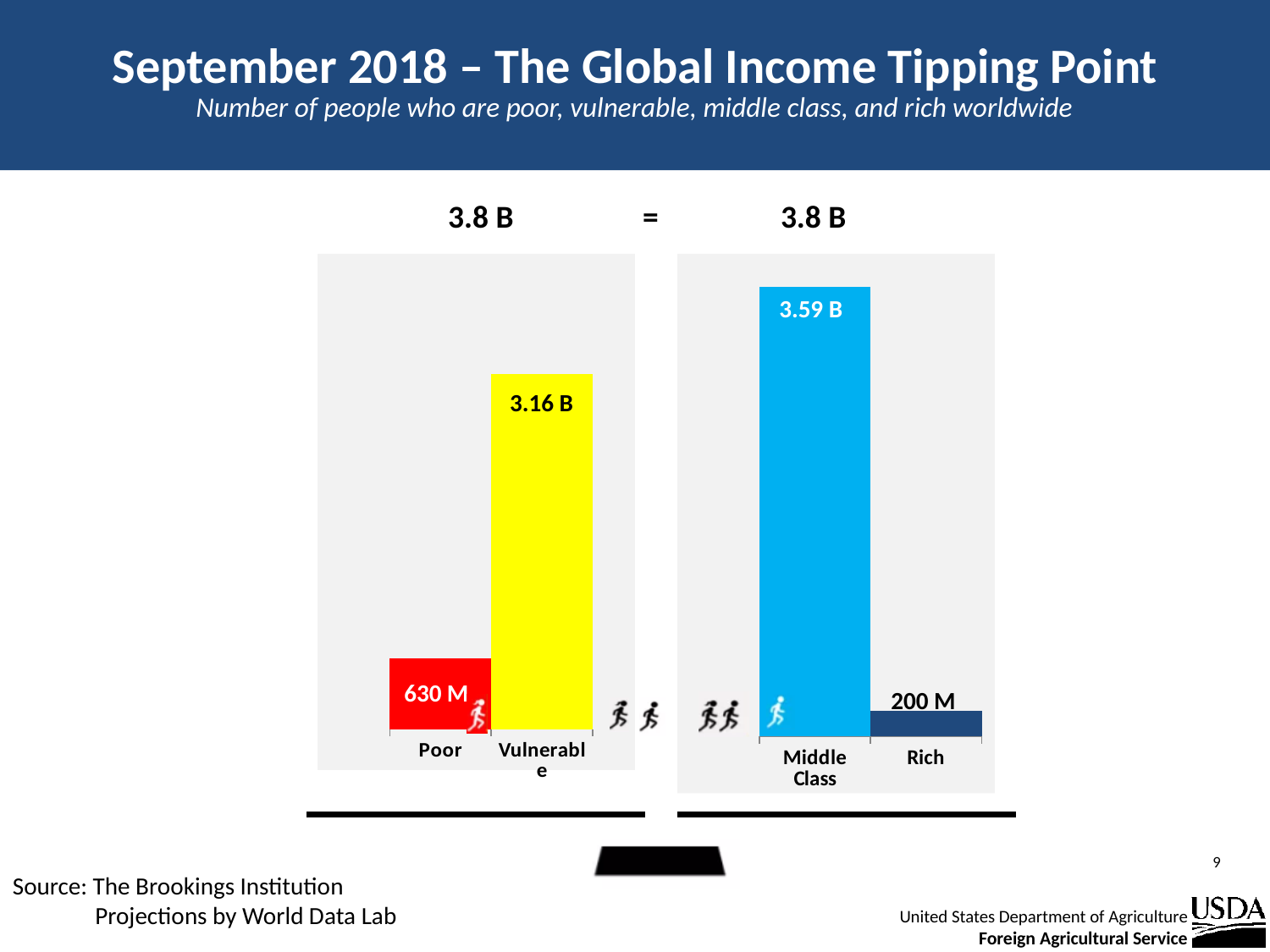
Which category has the lowest value? Rich What is the difference between the value for Poor and the value for Rich? 430 M What is the value for Vulnerable? 3.16 B What total is shown above the Poor and Vulnerable bars? 3.8 B What is the value for Middle Class? 3.59 B What is the value for Rich? 200 M What is the value for Poor? 630 M Which is larger, the value for Vulnerable or the value for Middle Class? Middle Class What kind of chart is shown on the slide? Bar chart Which category has the highest value? Middle Class Which is larger, the value for Poor or the value for Rich? Poor How many categories are shown across the bars on the slide? 4